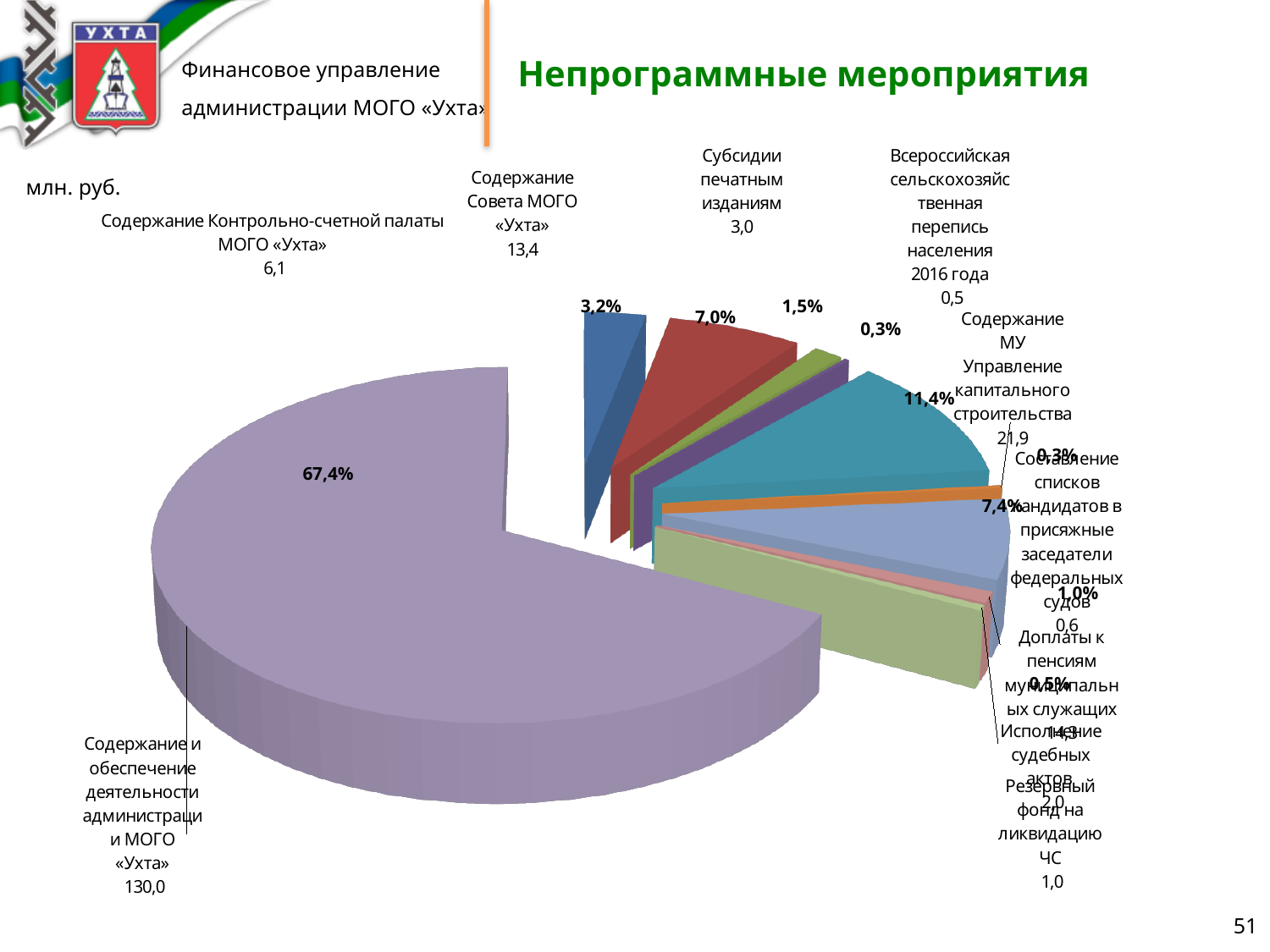
What kind of chart is shown on the slide? pie chart What is the difference between the values for «Содержание Совета МОГО «Ухта»» and «Содержание Контрольно-счетной палаты МОГО «Ухта»»? 7,3 Which category has the smallest value? Всероссийская сельскохозяйственная перепись населения 2016 года Which category has the largest slice of the pie? Содержание и обеспечение деятельности администрации МОГО «Ухта» In what units are the values on the chart given? млн. руб. What share of the pie does «Содержание МУ Управление капитального строительства» represent? 11,4% What is the value for «Содержание и обеспечение деятельности администрации МОГО «Ухта»»? 130,0 Which is larger: «Содержание Совета МОГО «Ухта»» or «Содержание Контрольно-счетной палаты МОГО «Ухта»»? Содержание Совета МОГО «Ухта» What is the value for «Субсидии печатным изданиям»? 3,0 What is the value for «Содержание Совета МОГО «Ухта»»? 13,4 What share of the pie does «Содержание и обеспечение деятельности администрации МОГО «Ухта»» represent? 67,4% What is the value for «Содержание МУ Управление капитального строительства»? 21,9